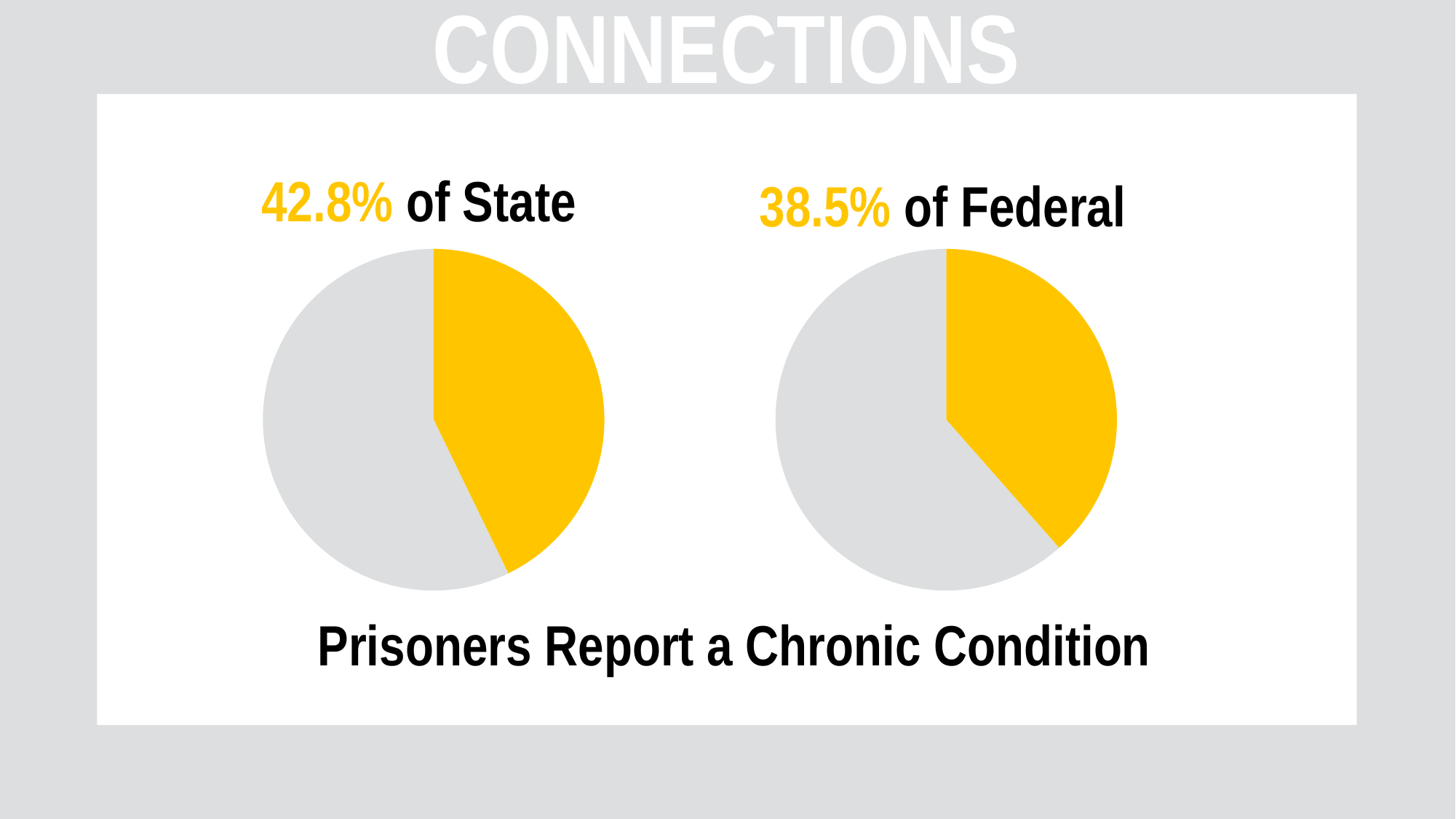
What caption appears below the two pie charts? Prisoners Report a Chronic Condition How many pie charts are shown on the slide? 2 Comparing the two pie charts, which group has the higher share of prisoners reporting a chronic condition, State or Federal? State In the right pie chart, is the share of Federal prisoners reporting a chronic condition greater or less than 50%? less What colour is used for the slice representing prisoners who report a chronic condition in both pie charts? Yellow In the left pie chart, is the share of State prisoners reporting a chronic condition greater or less than 50%? less What is the difference in percentage points between the State share (42.8%) and the Federal share (38.5%) of prisoners reporting a chronic condition? 4.3 percentage points In the right pie chart, what percentage of Federal prisoners report a chronic condition? 38.5% In the left pie chart, what percentage of State prisoners report a chronic condition? 42.8% How many slices does the left (State) pie chart have? 2 Comparing the two pie charts, which group has the lower share of prisoners reporting a chronic condition? Federal What kind of chart is used on this slide to show the share of prisoners reporting a chronic condition? Pie chart